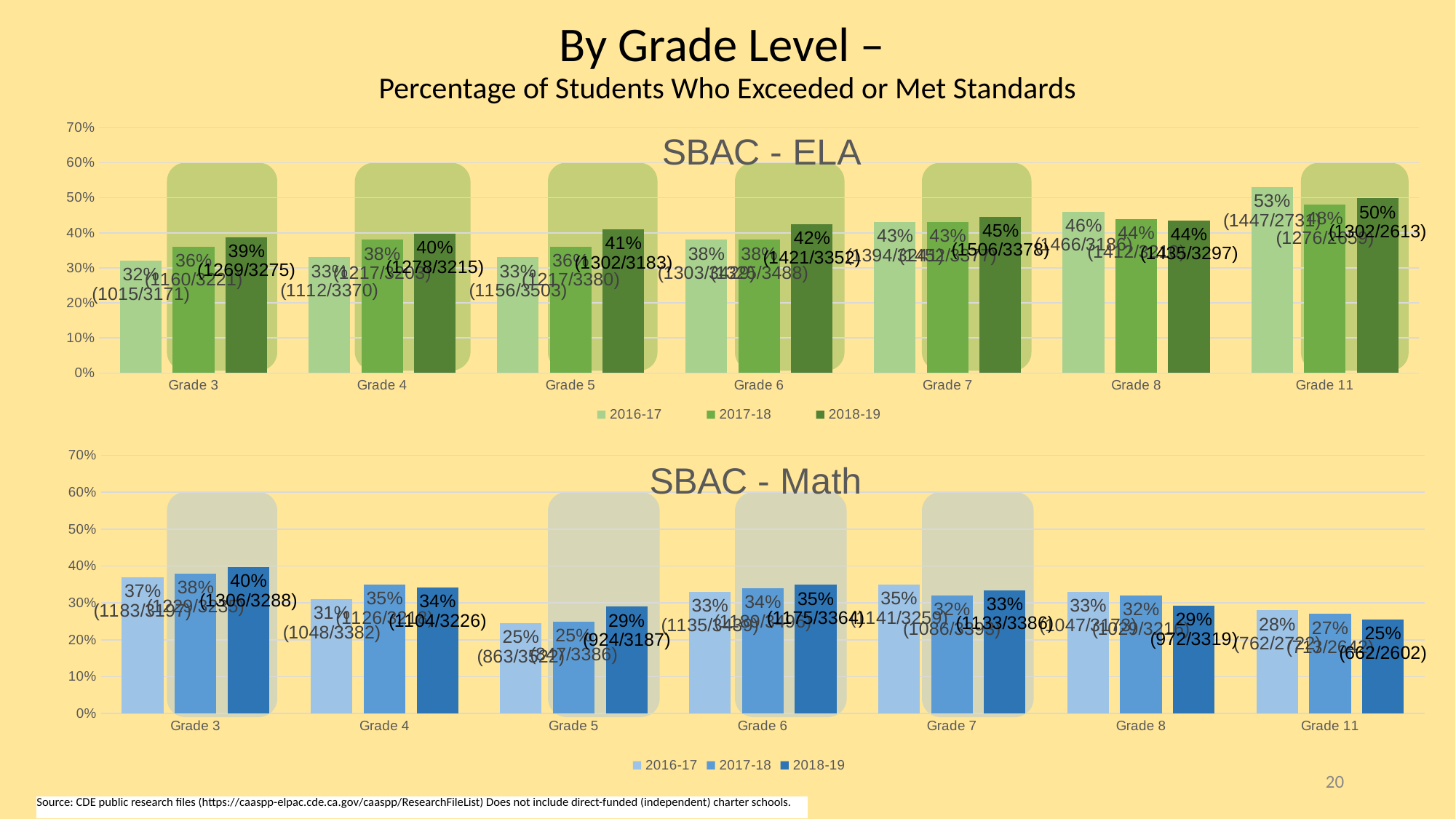
In the SBAC - Math chart, do the 2018-19 values rise or fall from Grade 7 to Grade 11? Fall In the SBAC - ELA chart, which grade has the highest value for 2016-17? Grade 11 What kind of chart is the SBAC - Math chart? Bar chart How many series does the legend of the SBAC - ELA chart list? 3 In the SBAC - Math chart, which grade has the lowest value for 2018-19? Grade 11 In the SBAC - ELA chart, what is the value for Grade 11 in 2018-19? 50% In the SBAC - Math chart, which is larger for Grade 8: the 2016-17 value or the 2018-19 value? 2016-17 How many grade levels are shown on the x axis of the SBAC - Math chart? 7 In the SBAC - ELA chart, what is the difference between the 2018-19 and 2016-17 values for Grade 5? 8 percentage points In the SBAC - Math chart, what is the value for Grade 5 in 2018-19? 29% In the SBAC - ELA chart, what is the value for Grade 3 in 2016-17? 32% In the SBAC - Math chart, which grade has the highest value for 2018-19? Grade 3